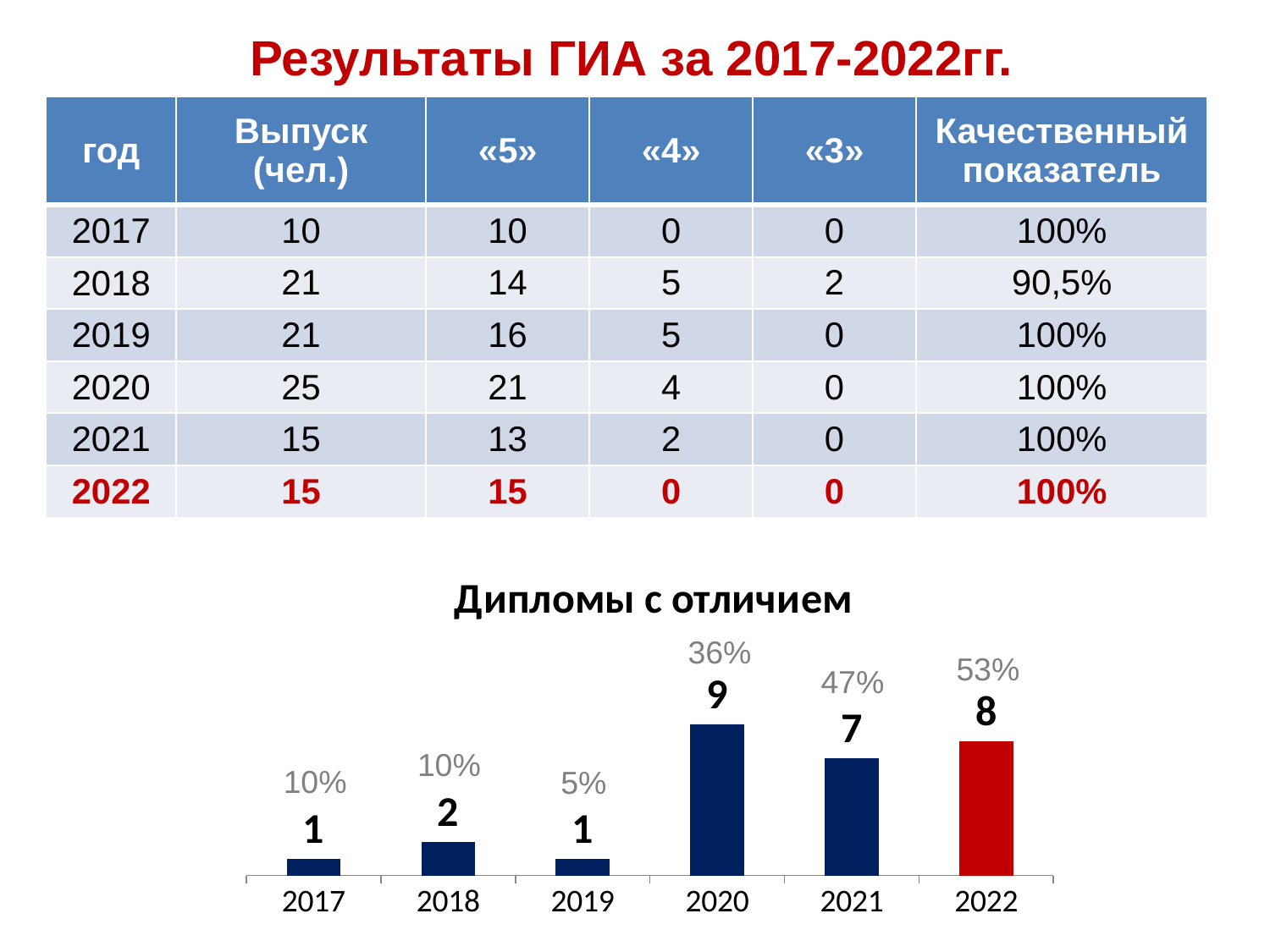
What type of chart is 'Дипломы с отличием'? Bar chart In the chart 'Дипломы с отличием', which year's bar is coloured red instead of dark blue? 2022 In the chart 'Дипломы с отличием', which year has the larger value, 2021 or 2022? 2022 In the chart 'Дипломы с отличием', what percentage is shown above the 2021 bar? 47% In the chart 'Дипломы с отличием', what percentage is shown for 2019? 5% In the chart 'Дипломы с отличием', which year has the highest number of diplomas with distinction? 2020 In the chart 'Дипломы с отличием', what is the difference between the values for 2022 and 2018? 6 In the chart 'Дипломы с отличием', what is the difference between the values for 2020 and 2021? 2 In the chart 'Дипломы с отличием', what value is shown for 2022? 8 How many years are shown on the x axis of the chart 'Дипломы с отличием'? 6 In the chart 'Дипломы с отличием', how many diplomas with distinction were there in 2020? 9 In the chart 'Дипломы с отличием', which year has the lowest percentage label? 2019